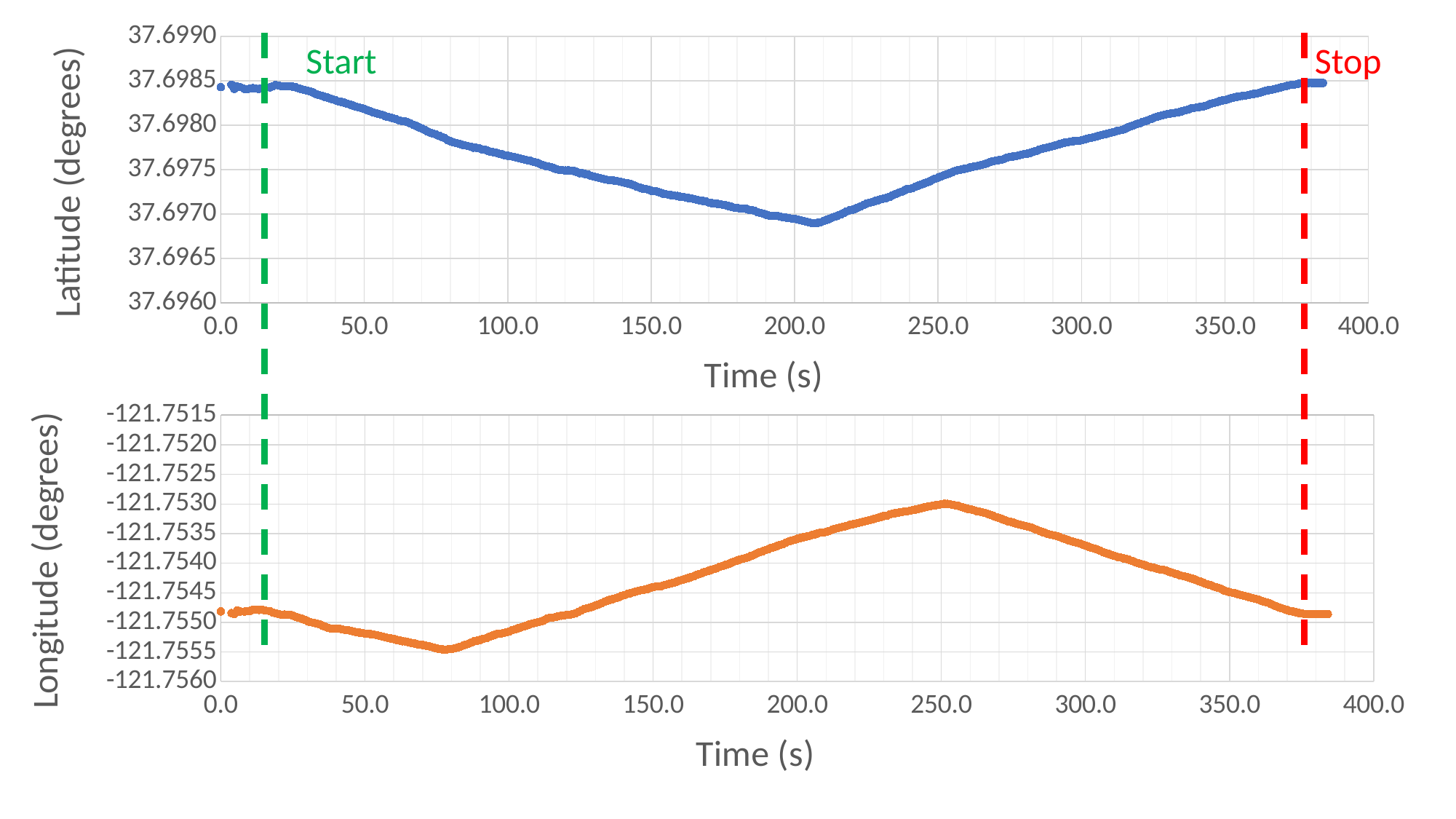
What kind of chart is the top chart (Latitude vs Time)? scatter chart In the top chart, does the latitude rise or fall between time 50.0 and time 200.0? fall In the top chart, does the latitude rise or fall between time 250.0 and time 350.0? rise In the top chart, is the latitude at time 100.0 greater or less than 37.6975? greater In the top chart, is the lowest latitude reached greater or less than 37.6970? less In the top chart, what is the label of the vertical axis? Latitude (degrees) In the bottom chart, what is the label of the vertical axis? Longitude (degrees) In the bottom chart, does the longitude rise or fall between time 100.0 and time 250.0? rise In the bottom chart, is the longitude at time 80.0 greater or less than -121.7550? less What is the label on the red dashed vertical line in the top chart? Stop